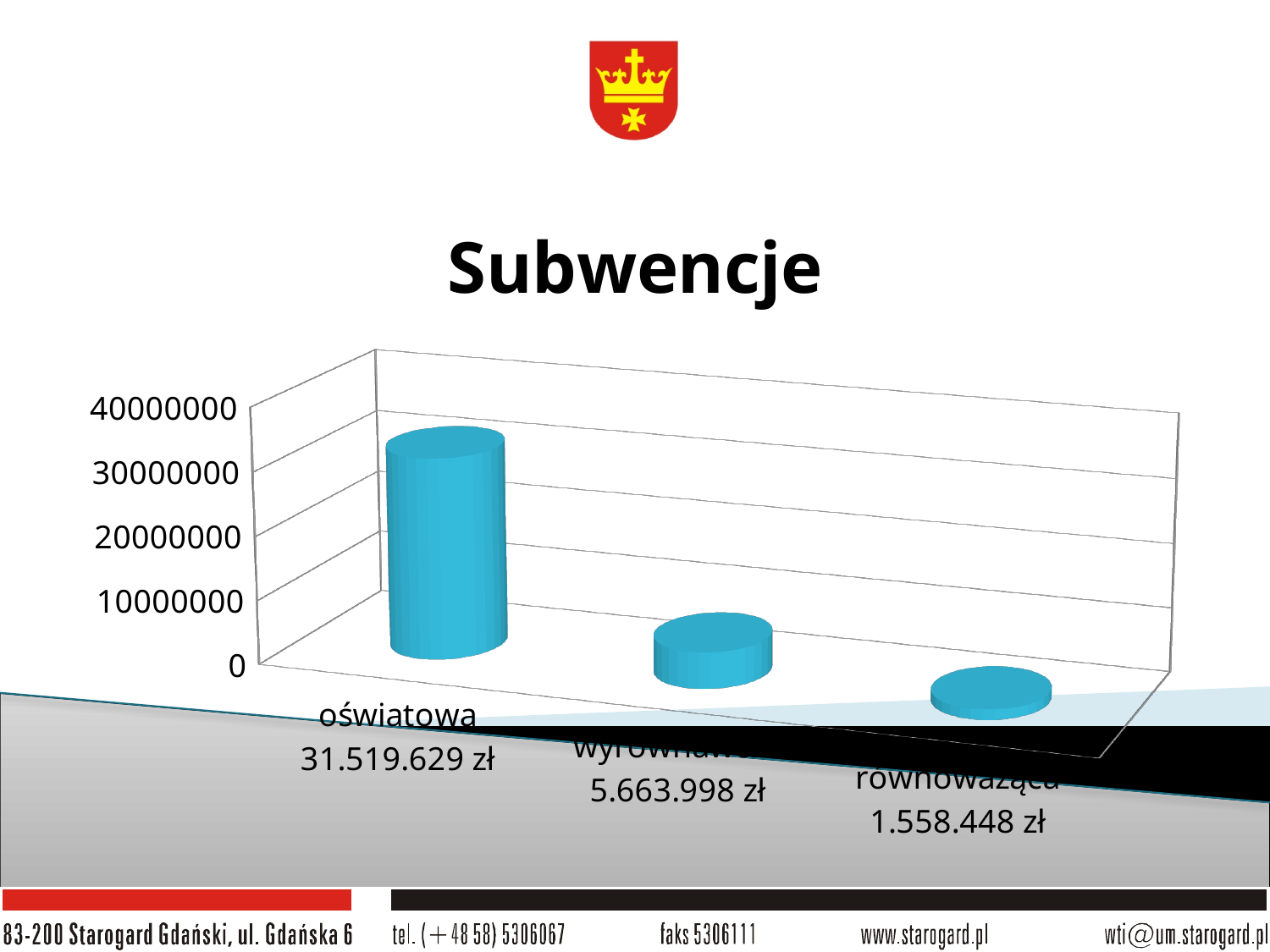
How many categories are plotted in the chart? 3 Which category has the highest value? oświatowa What is the value for the 'równoważąca' category? 1.558.448 zł What is the value shown for the middle bar of the chart? 5.663.998 zł Which category has the lowest value? równoważąca What is the value for the 'oświatowa' category? 31.519.629 zł What is the title of the chart? Subwencje Which is larger: the value for 'oświatowa' or the value for 'równoważąca'? oświatowa Is the value for 'oświatowa' greater or less than 30000000? greater What type of chart is shown on the slide? bar chart What is the difference between the 'oświatowa' value and the 'równoważąca' value? 29.961.181 zł Do the values rise or fall from left to right across the categories? fall